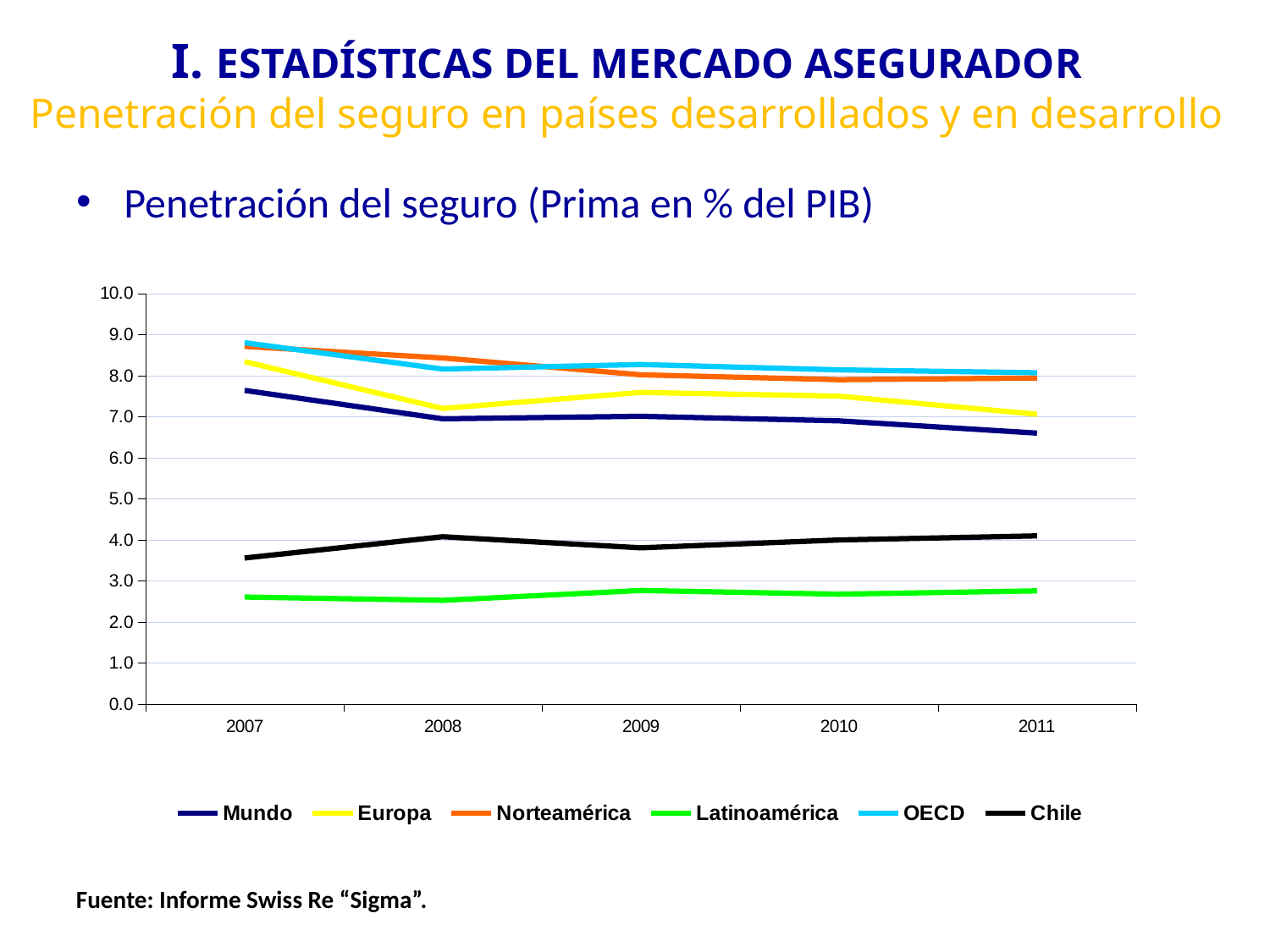
Which series has the lowest values across all years? Latinoamérica In 2010, which is larger: Chile or Latinoamérica? Chile Is the value for Europa in 2007 greater or less than 8.0? greater Does the Mundo series rise or fall from 2007 to 2011? fall Is the value for Mundo in 2011 greater or less than 7.0? less How many years are plotted along the x axis? 5 What source is cited below the chart? Informe Swiss Re "Sigma" What kind of chart is shown on the slide? line chart Does the Chile series rise or fall from 2007 to 2011? rise How many series does the legend list? 6 Is the value for Latinoamérica in 2009 greater or less than 3.0? less